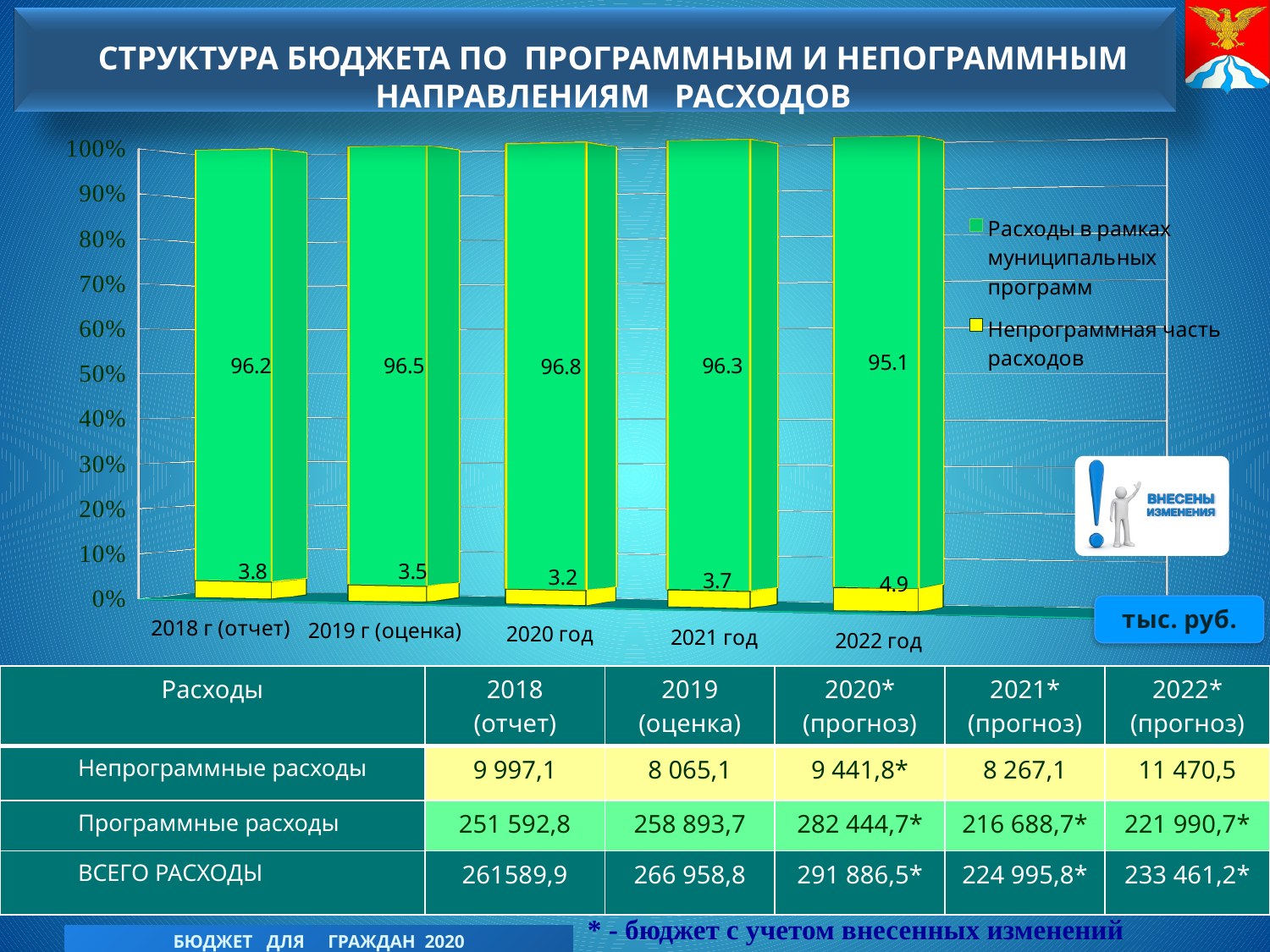
In which year is the yellow series (Непрограммная часть расходов) lowest? 2020 год How many year categories are shown on the x axis of the chart? 5 What is the value of the green series (Расходы в рамках муниципальных программ) for 2020 год? 96.8 Which is larger: the green series value for 2019 г (оценка) or for 2022 год? 2019 г (оценка) What is the value of the yellow series (Непрограммная часть расходов) for 2022 год? 4.9 In which year is the green series (Расходы в рамках муниципальных программ) highest? 2020 год What kind of chart is shown on the slide? Stacked bar chart What is the value of the yellow series (Непрограммная часть расходов) for 2018 г (отчет)? 3.8 What is the difference between the yellow series values for 2022 год and 2021 год? 1.2 Which colour represents Непрограммная часть расходов in the chart? Yellow How many series does the chart legend list? 2 In which year is the yellow series (Непрограммная часть расходов) highest? 2022 год